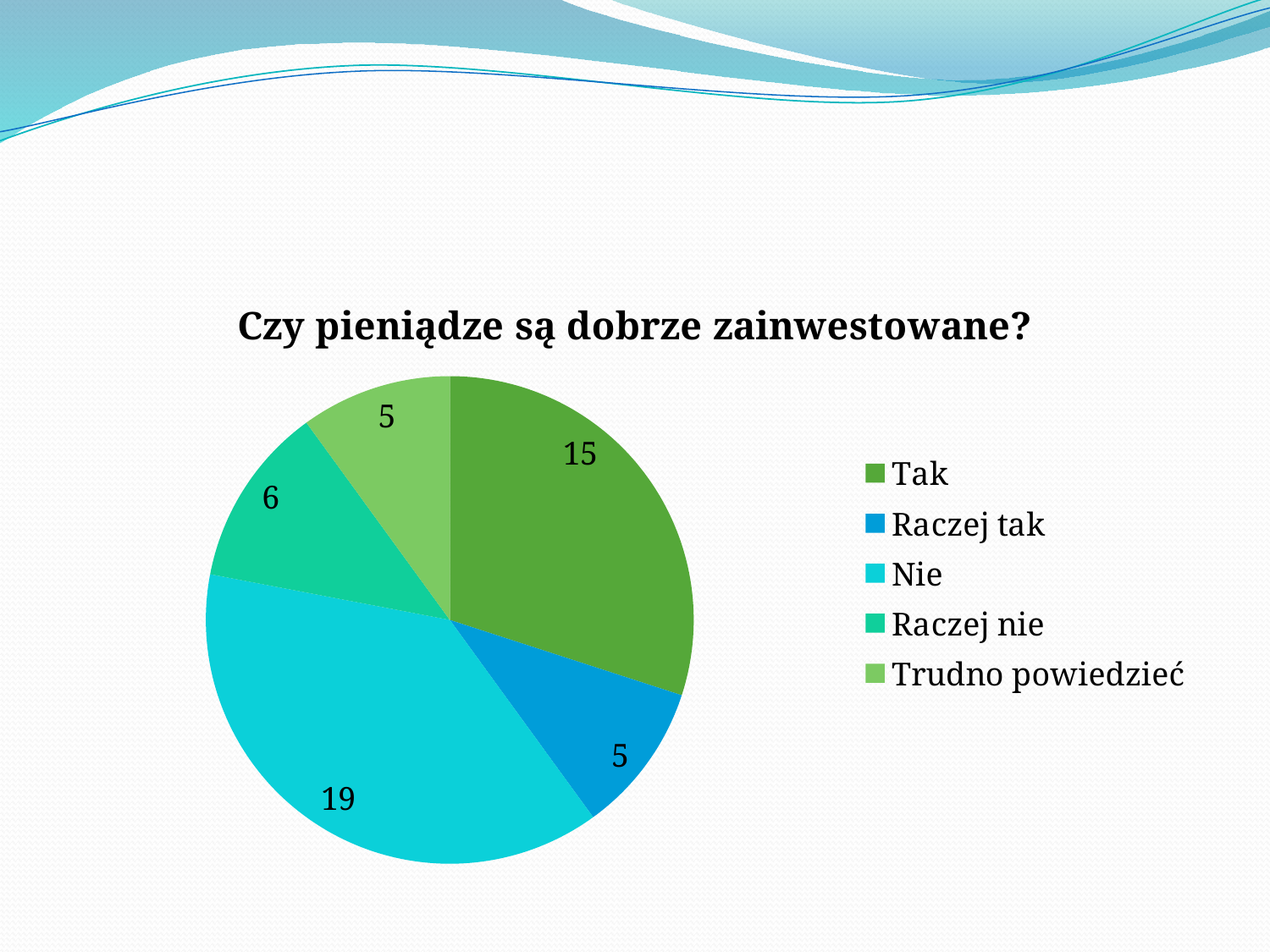
What is the difference between the values for "Nie" and "Tak"? 4 What is the value for "Raczej tak"? 5 What share of the pie does "Nie" represent? 38% What is the value for "Nie"? 19 Which is larger, the value for "Tak" or the value for "Raczej nie"? Tak What type of chart is shown on the slide? pie chart Which category has the largest slice? Nie What is the value for "Raczej nie"? 6 What is the value for "Tak"? 15 What is the total of all slices in the pie? 50 What is the title of the chart? Czy pieniądze są dobrze zainwestowane? How many categories does the legend list? 5